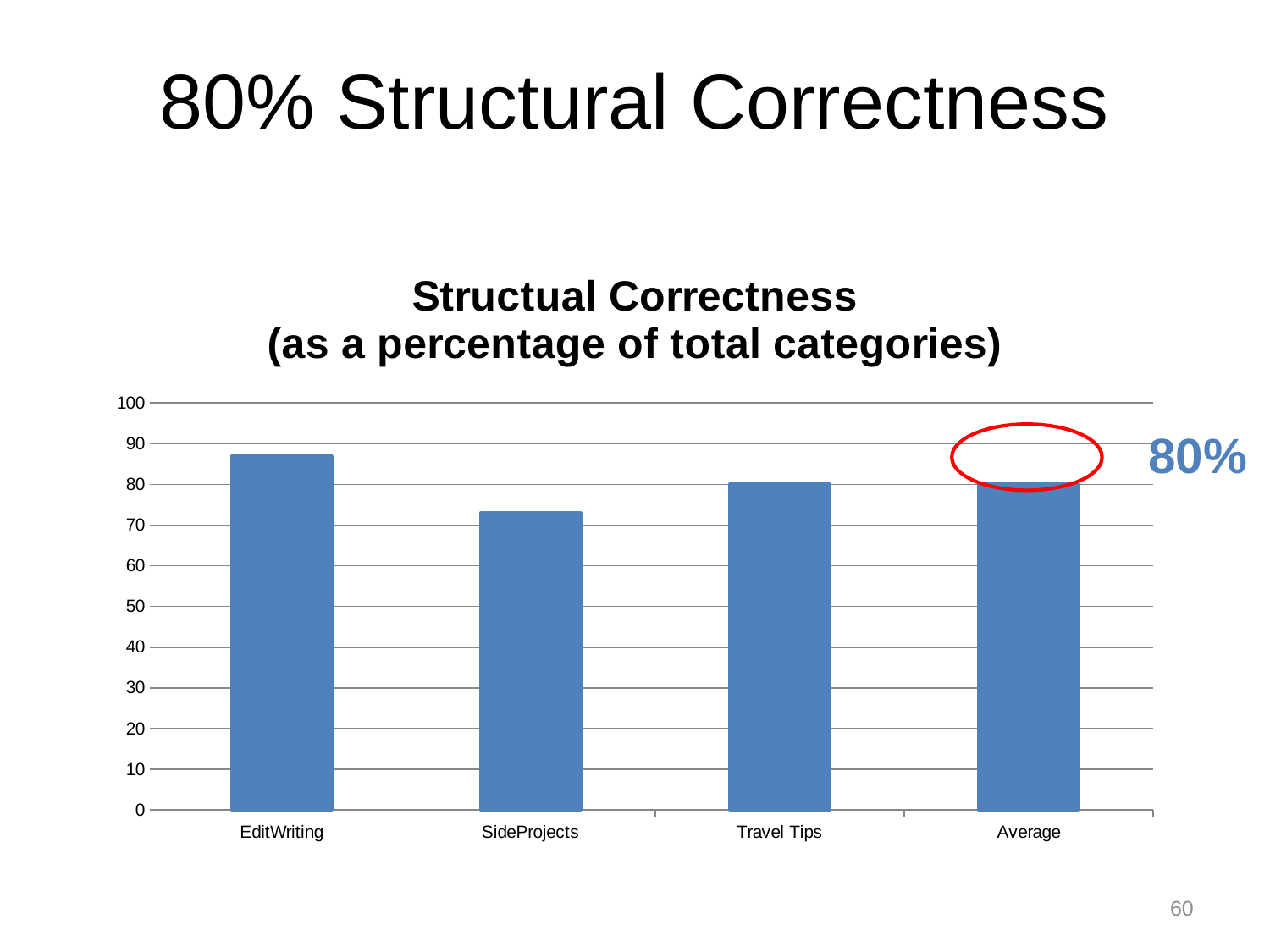
Is the value for SideProjects greater or less than 80? less Is the value for Travel Tips greater or less than 70? greater Which category has the highest bar in the chart? EditWriting Which is larger, the value for SideProjects or the value for Average? Average Is the value for SideProjects greater or less than 70? greater What is the title of the chart? Structual Correctness (as a percentage of total categories) How many categories are plotted on the x axis of the chart? 4 What value is annotated next to the circled Average bar? 80% Which category has the lowest bar in the chart? SideProjects Which is larger, the value for EditWriting or the value for SideProjects? EditWriting What kind of chart is shown on the slide? bar chart